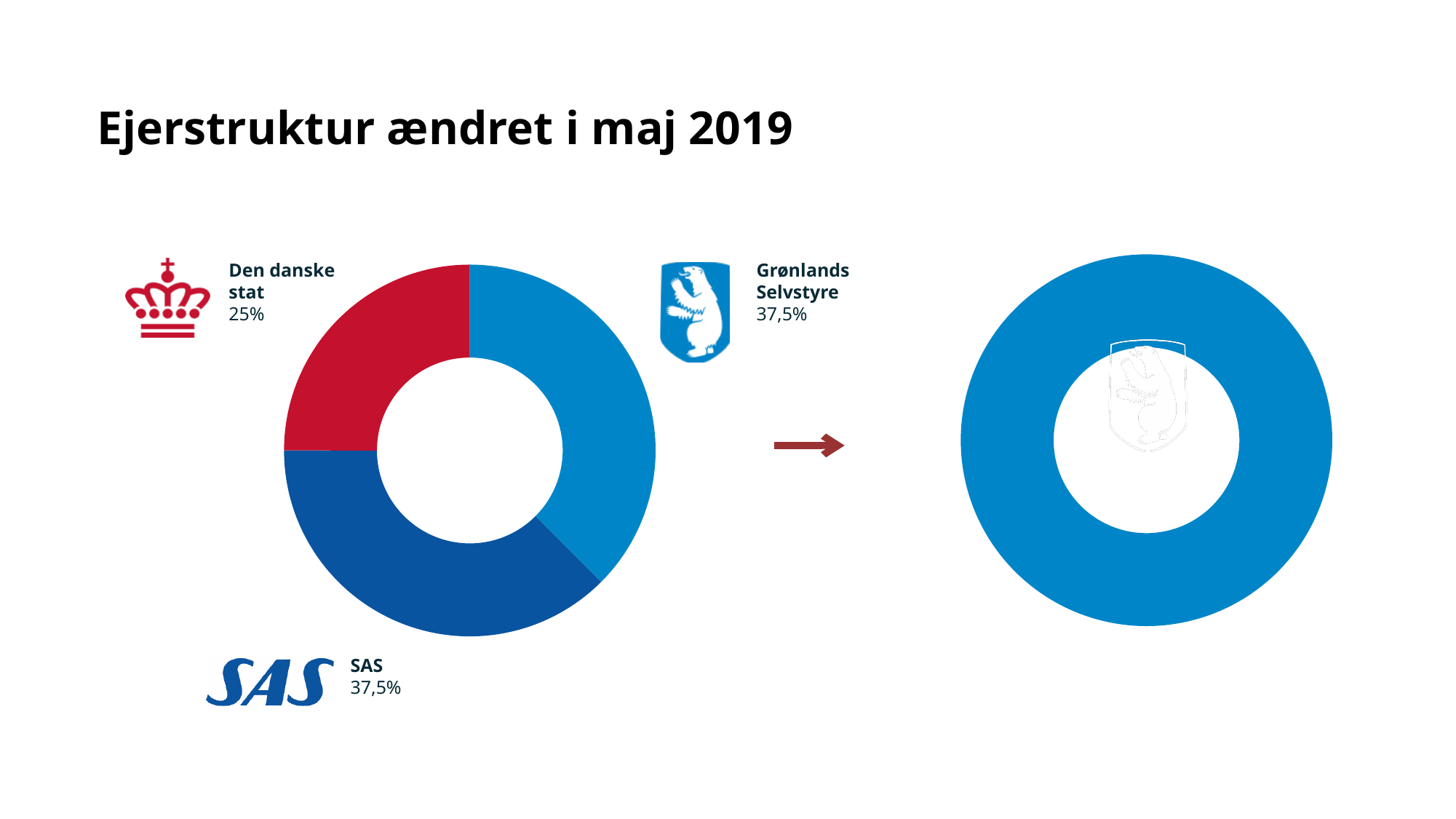
In the left donut chart, which is larger: the share of Grønlands Selvstyre or the share of Den danske stat? Grønlands Selvstyre What is the title of the slide? Ejerstruktur ændret i maj 2019 In the left donut chart, what share does Den danske stat hold? 25% In the left donut chart, which owner has the smallest share? Den danske stat In the left donut chart, what is the difference between the share of SAS and the share of Den danske stat? 12,5% In the left donut chart, what is the combined share of Grønlands Selvstyre and SAS? 75% How many slices does the right donut chart contain? 1 In the left donut chart, what share does SAS hold? 37,5% In the left donut chart, what share does Grønlands Selvstyre hold? 37,5% In the left donut chart, what colour is the slice for Den danske stat? Red How many owners (slices) are shown in the left donut chart? 3 What kind of chart is shown on the left of the slide? Donut (pie) chart